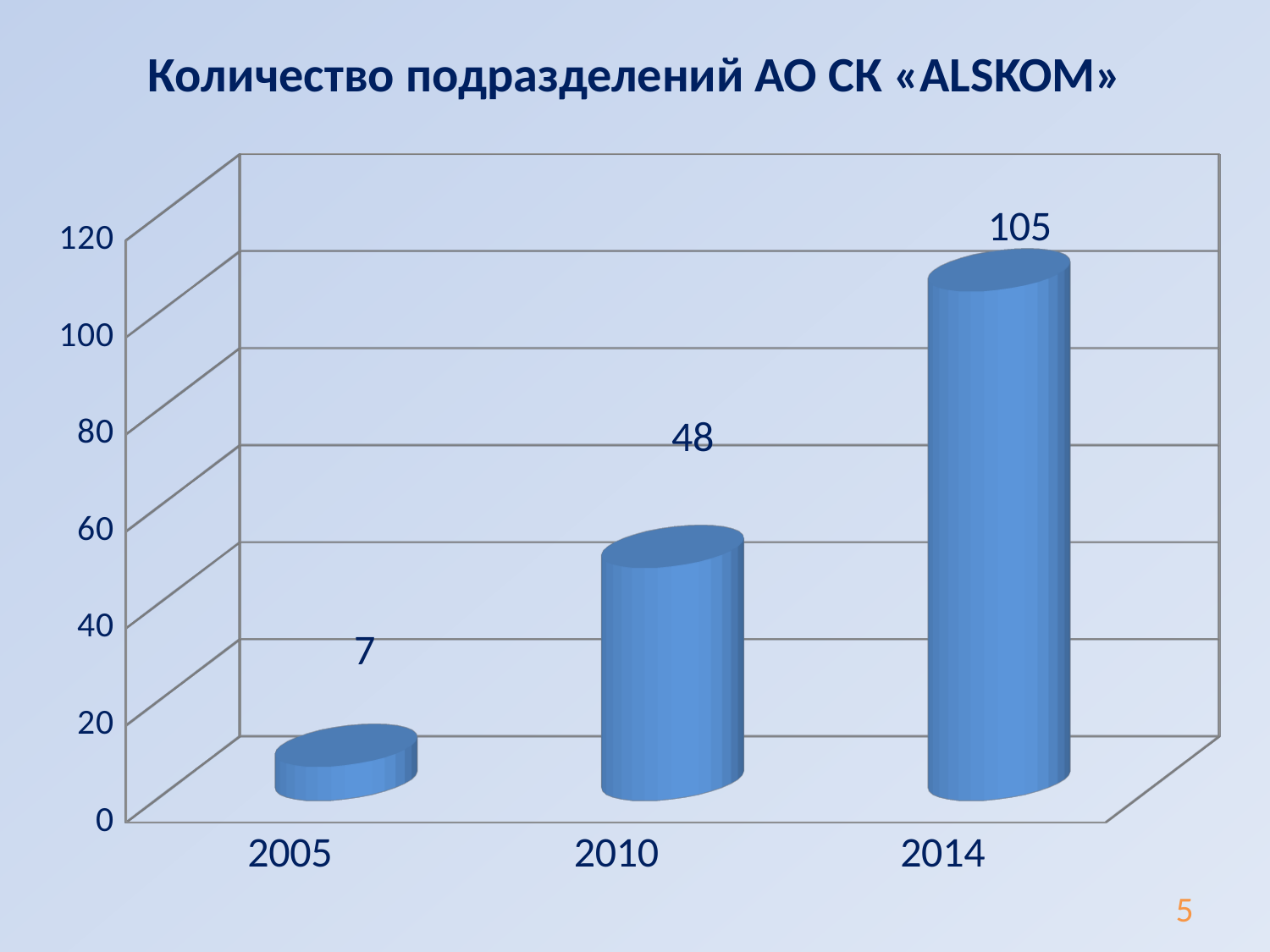
What is the value for 2005? 7 What is the value for 2010? 48 Which year has the highest value? 2014 What kind of chart is shown on the slide? bar chart Is the value for 2014 greater or less than 100? greater What is the value for 2014? 105 How many years are shown on the x axis? 3 What is the difference between the values for 2010 and 2005? 41 Which is larger, the value for 2010 or the value for 2005? 2010 Which year has the lowest value? 2005 What is the difference between the values for 2014 and 2010? 57 Do the values rise or fall from 2005 to 2014? rise